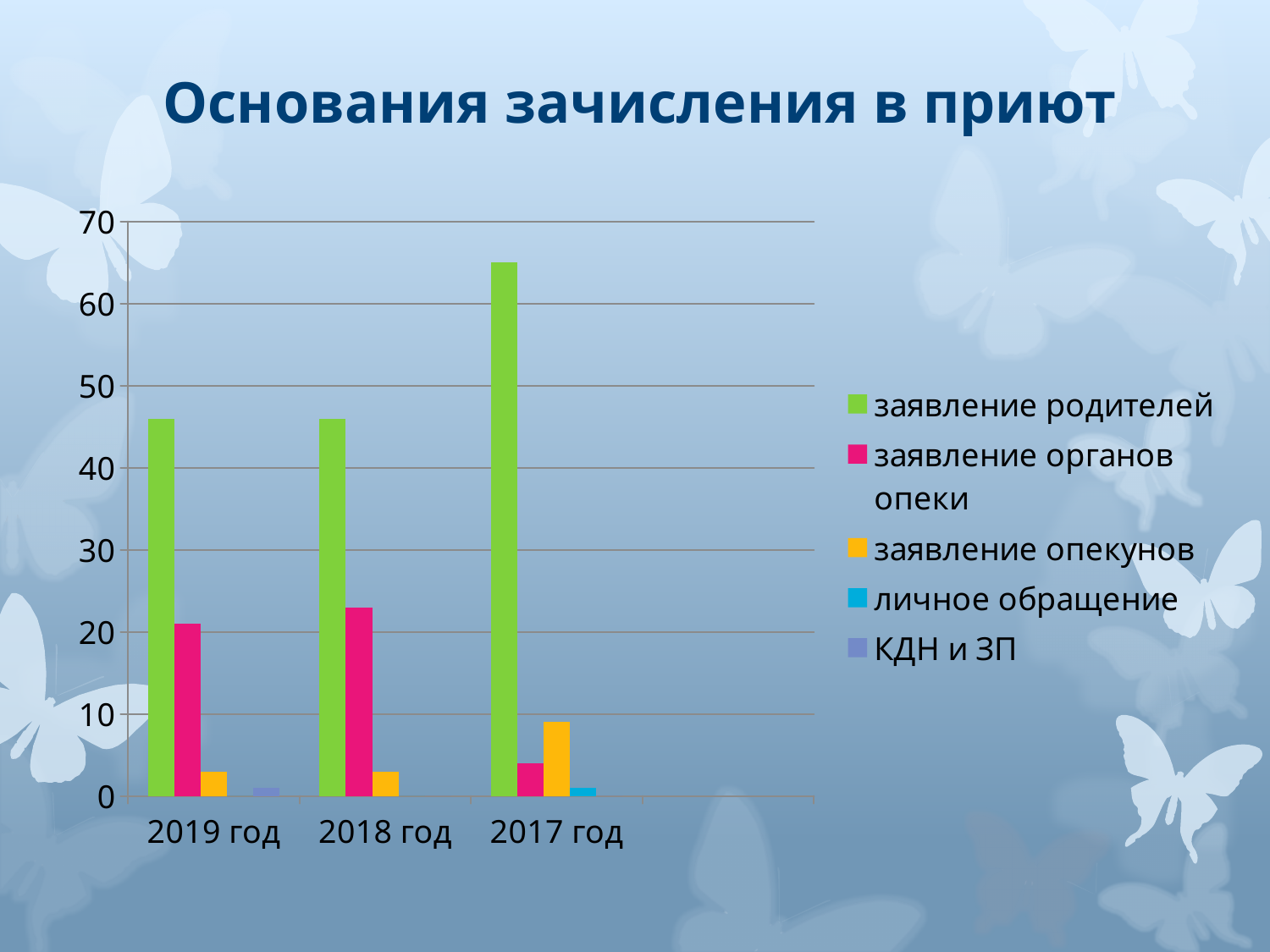
What kind of chart is shown on the slide? bar chart Which series has the highest value in 2019 год? заявление родителей In which year is the value for "заявление родителей" the highest? 2017 год How many years are shown on the x axis? 3 How many series does the legend list? 5 In which year is the value for "заявление органов опеки" the lowest? 2017 год Which is larger: "заявление органов опеки" in 2018 год or in 2017 год? 2018 год Is the value for "заявление родителей" in 2017 год greater or less than 60? greater Is the value for "заявление органов опеки" in 2018 год greater or less than 20? greater What is the title of the chart? Основания зачисления в приют Is the value for "заявление родителей" in 2019 год greater or less than 50? less